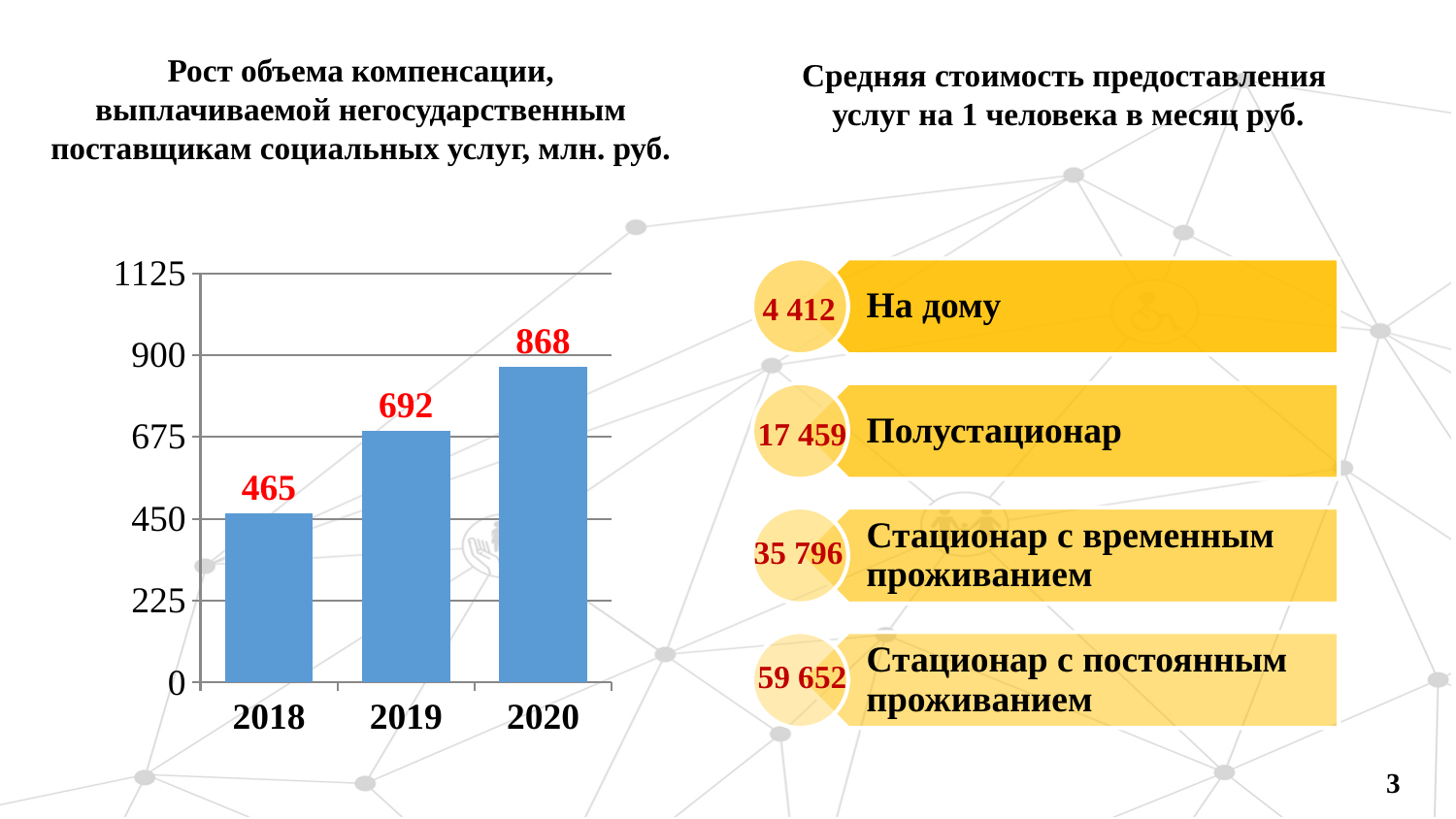
Is the value for 2019 in the bar chart greater or less than 675? greater What is the difference between the values for 2019 and 2018 in the bar chart? 227 Which year has the lowest value in the bar chart? 2018 How many years are shown on the x axis of the bar chart? 3 What is the value for 2020 in the bar chart? 868 What is the value for 2018 in the bar chart? 465 Do the values in the bar chart rise or fall from 2018 to 2020? rise What is the difference between the values for 2020 and 2018 in the bar chart? 403 Which year has the highest value in the bar chart? 2020 What kind of chart is shown on the left of the slide? bar chart Which is larger in the bar chart, the value for 2019 or the value for 2020? 2020 What is the value for 2019 in the bar chart? 692